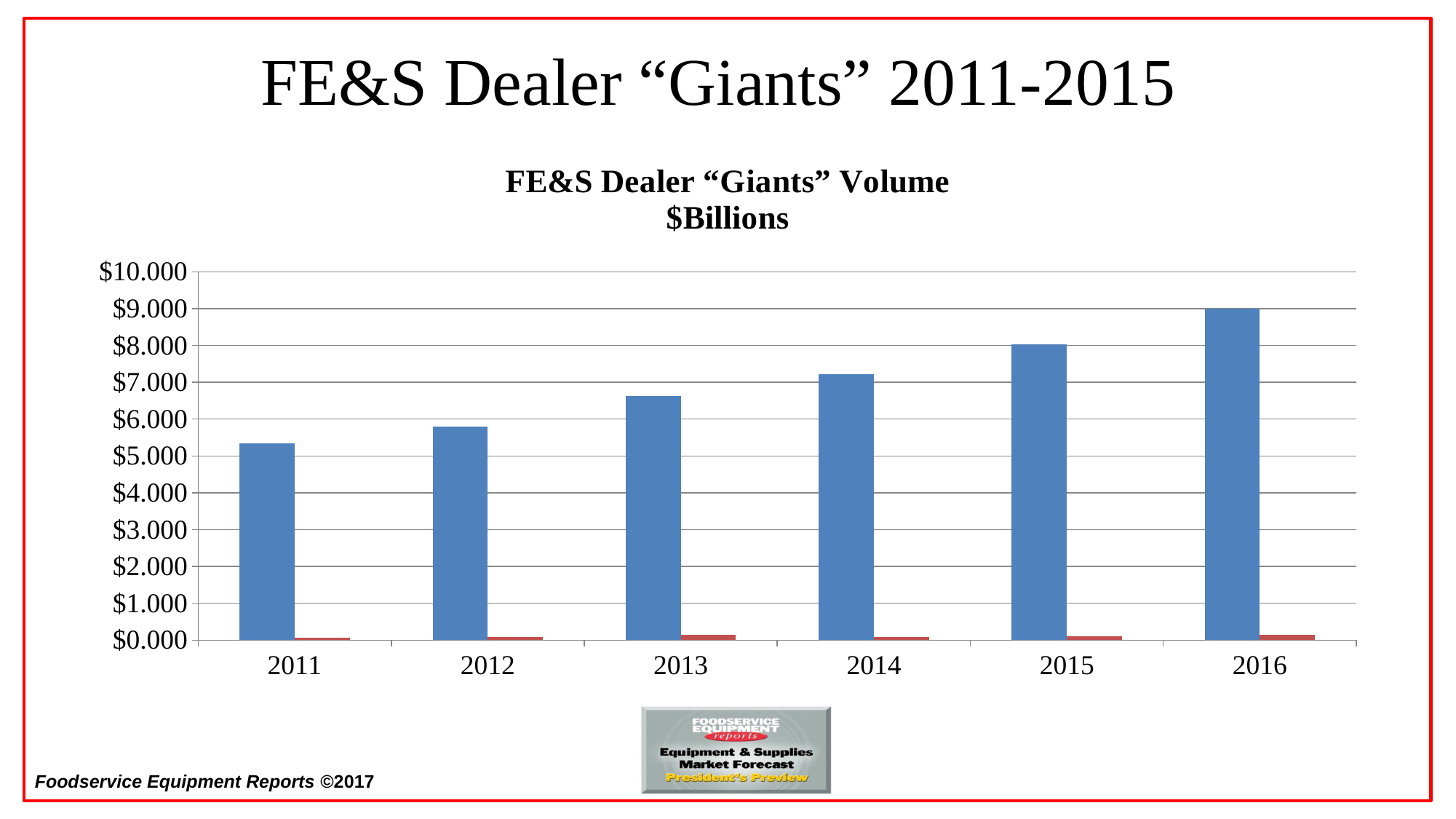
How many years are shown on the x axis of the chart? 6 Is the blue bar value for 2011 greater or less than $5.000? greater Is the blue bar value for 2016 greater or less than $8.000? greater Which year has the tallest blue bar? 2016 Is the blue bar value for 2014 greater or less than $8.000? less Do the blue bars rise or fall from 2011 to 2016? rise Which year has the shortest blue bar? 2011 What is the title of the chart? FE&S Dealer "Giants" Volume $Billions What kind of chart is shown on the slide? bar chart Which year has a taller blue bar, 2012 or 2014? 2014